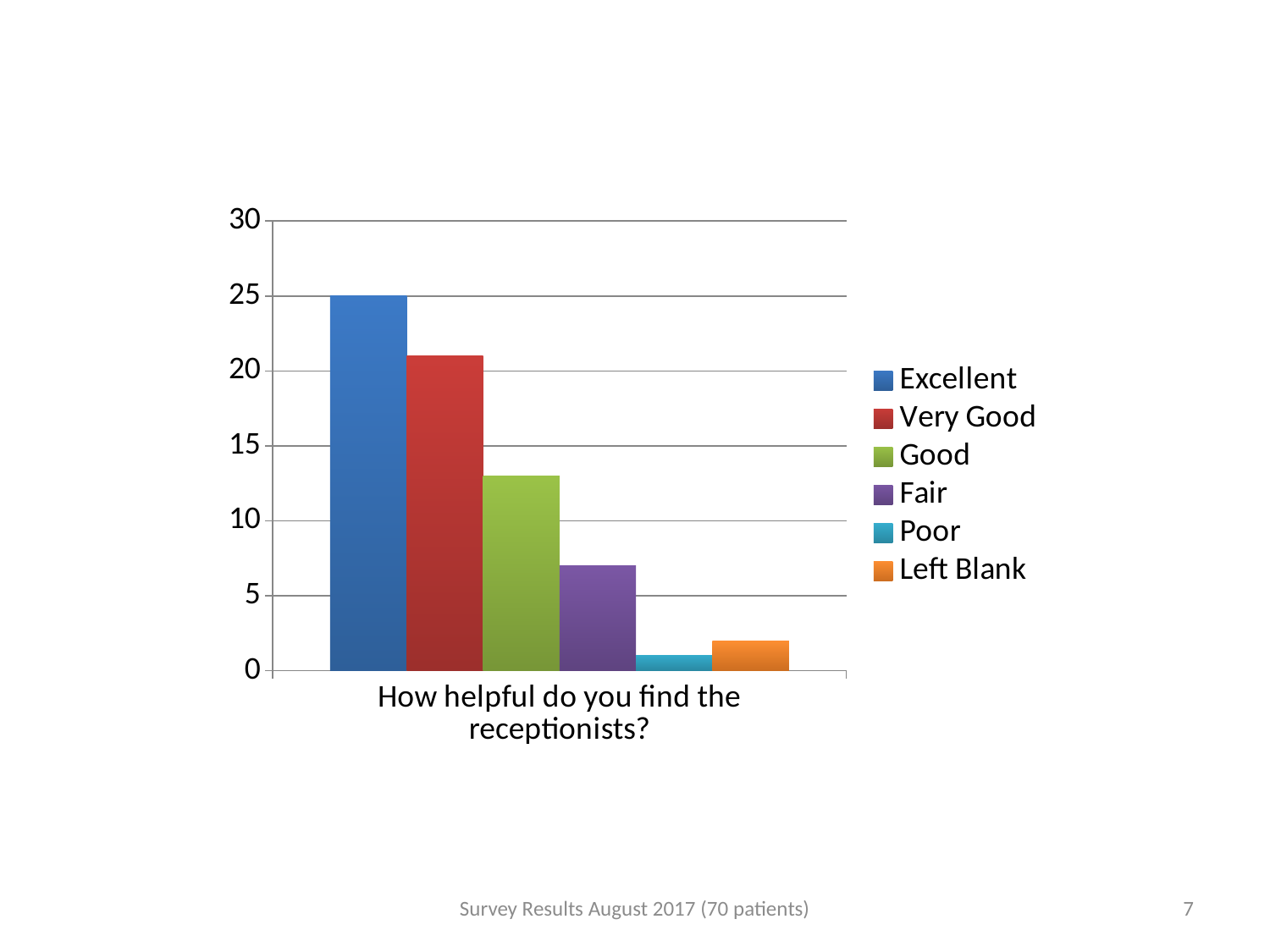
Which is larger, the value for Good or the value for Fair? Good What kind of chart is shown on the slide? bar chart What is the value for Excellent? 25 Which series has the highest value? Excellent Which is larger, the value for Poor or the value for Left Blank? Left Blank How many series does the legend list? 6 Which series has the lowest value? Poor Is the value for Very Good greater or less than 20? greater Is the value for Left Blank greater or less than 5? less What question is shown as the category label beneath the bars? How helpful do you find the receptionists? Is the value for Fair greater or less than 5? greater